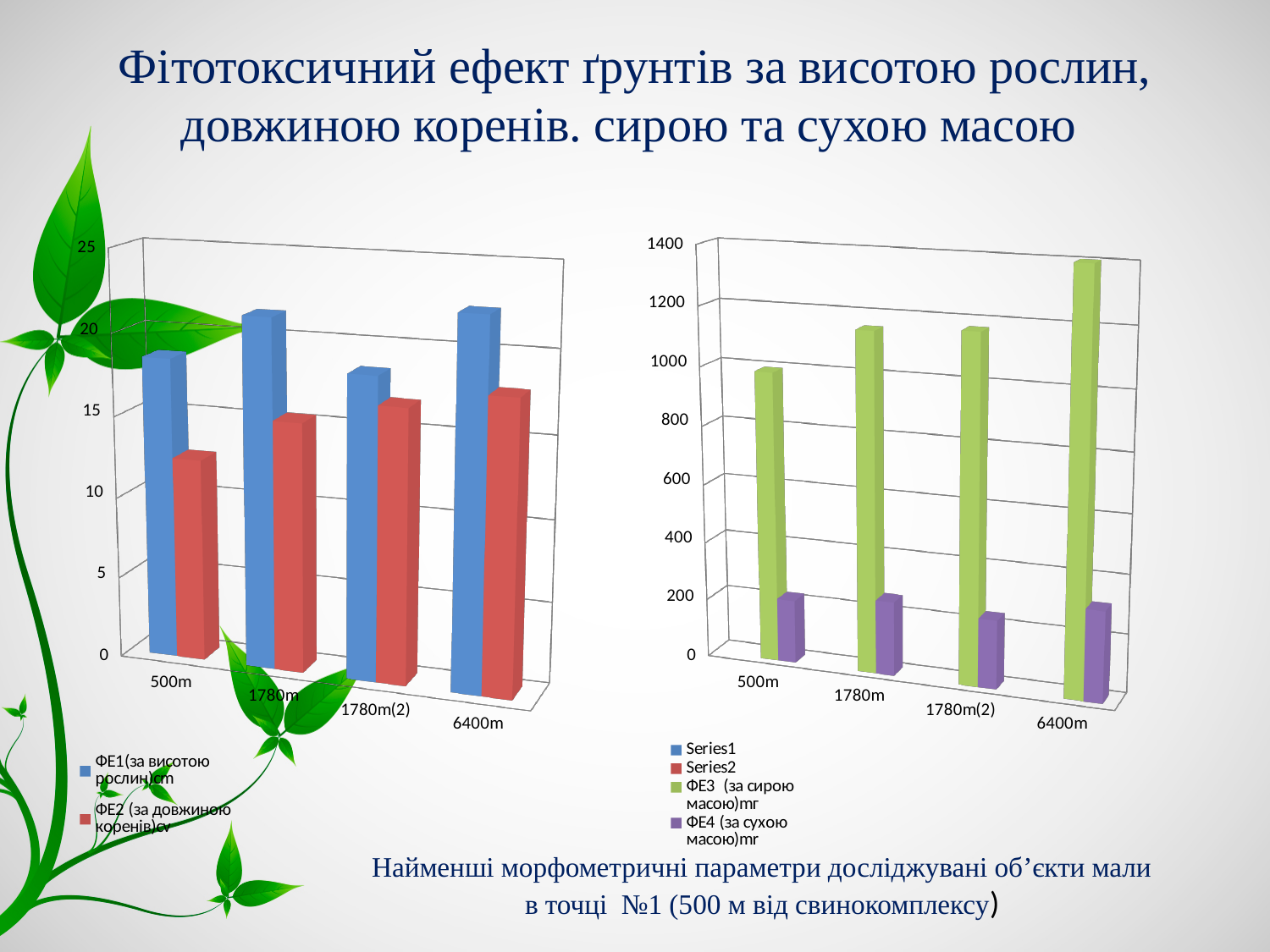
In the right chart, is the value of ФЕ4 (за сухою масою)mr at 500m greater or less than 400? less What colour are the bars for ФЕ3 (за сирою масою)mr in the right chart? green In the left chart, is the value of ФЕ2 (за довжиною коренів)cv at 500m greater or less than 15? less In the left chart, which category has the lowest value for ФЕ2 (за довжиною коренів)cv? 500m What kind of chart is the left chart on the slide? bar chart How many series does the legend of the left chart list? 2 In the right chart, is the value of ФЕ3 (за сирою масою)mr at 6400m greater or less than 1200? greater In the right chart, which category has the lowest value for ФЕ3 (за сирою масою)mr? 500m How many entries does the legend of the right chart list? 4 In the left chart, at 500m, which is larger: ФЕ1 (за висотою рослин)cm or ФЕ2 (за довжиною коренів)cv? ФЕ1 (за висотою рослин)cm In the right chart, which category has the highest value for ФЕ3 (за сирою масою)mr? 6400m How many categories are shown on the x axis of the right chart? 4